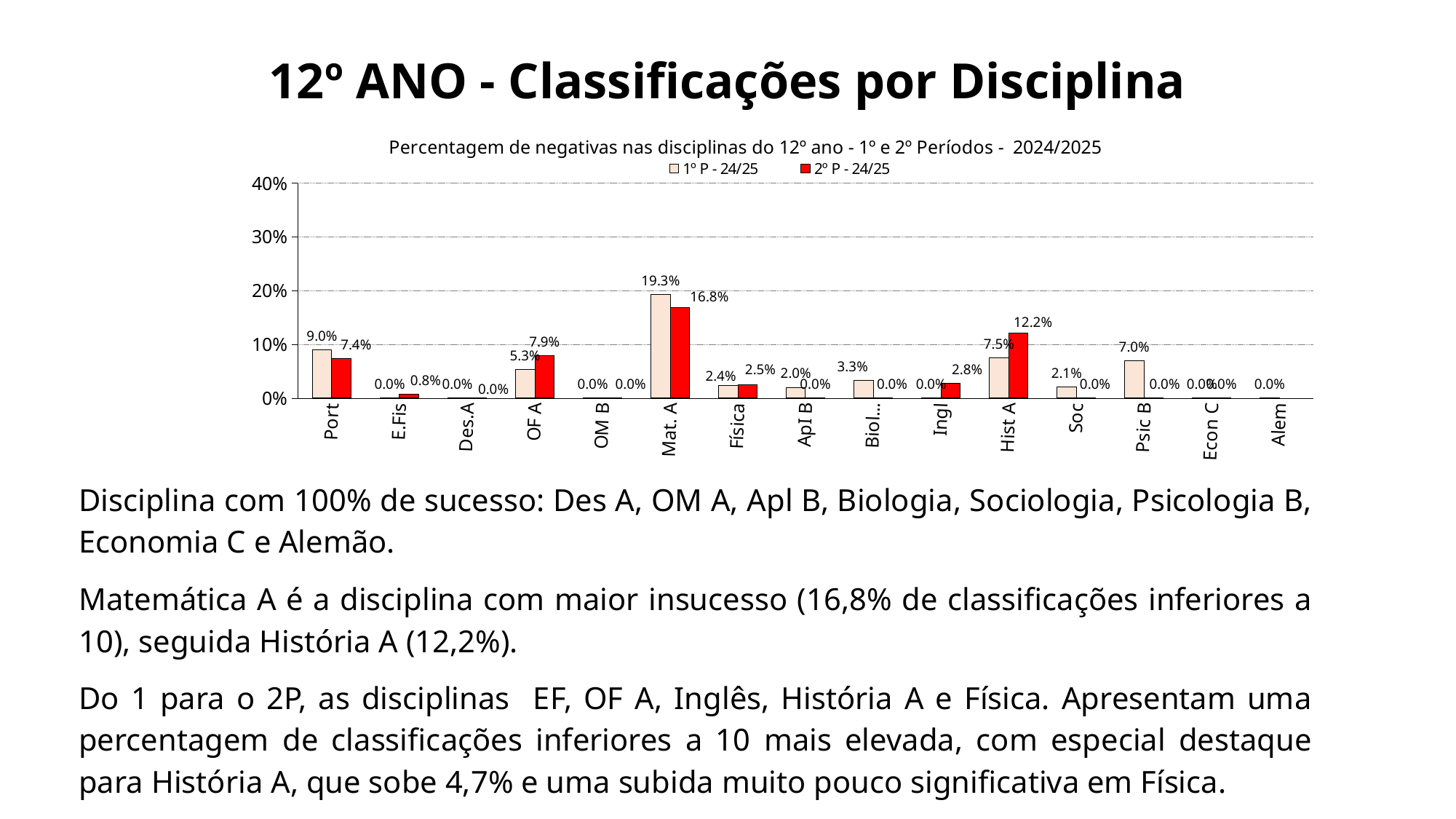
How many series does the chart legend list? 2 What colour are the bars for the 2º P - 24/25 series? red What is the value for Hist A in the 2º P - 24/25 series? 12.2% What is the difference between the 1º P - 24/25 and 2º P - 24/25 values for Mat. A? 2.5% What type of chart is shown on the slide? bar chart What is the difference between the 1º P - 24/25 and 2º P - 24/25 values for Hist A? 4.7% Which discipline has the highest value in the 2º P - 24/25 series? Mat. A How many disciplines (categories) are shown on the x axis of the chart? 15 What is the value for Psic B in the 1º P - 24/25 series? 7.0% What is the value for Mat. A in the 1º P - 24/25 series? 19.3% Is the value for Mat. A in the 1º P - 24/25 series greater or less than 10%? greater For OF A, which series has the larger value: 1º P - 24/25 or 2º P - 24/25? 2º P - 24/25